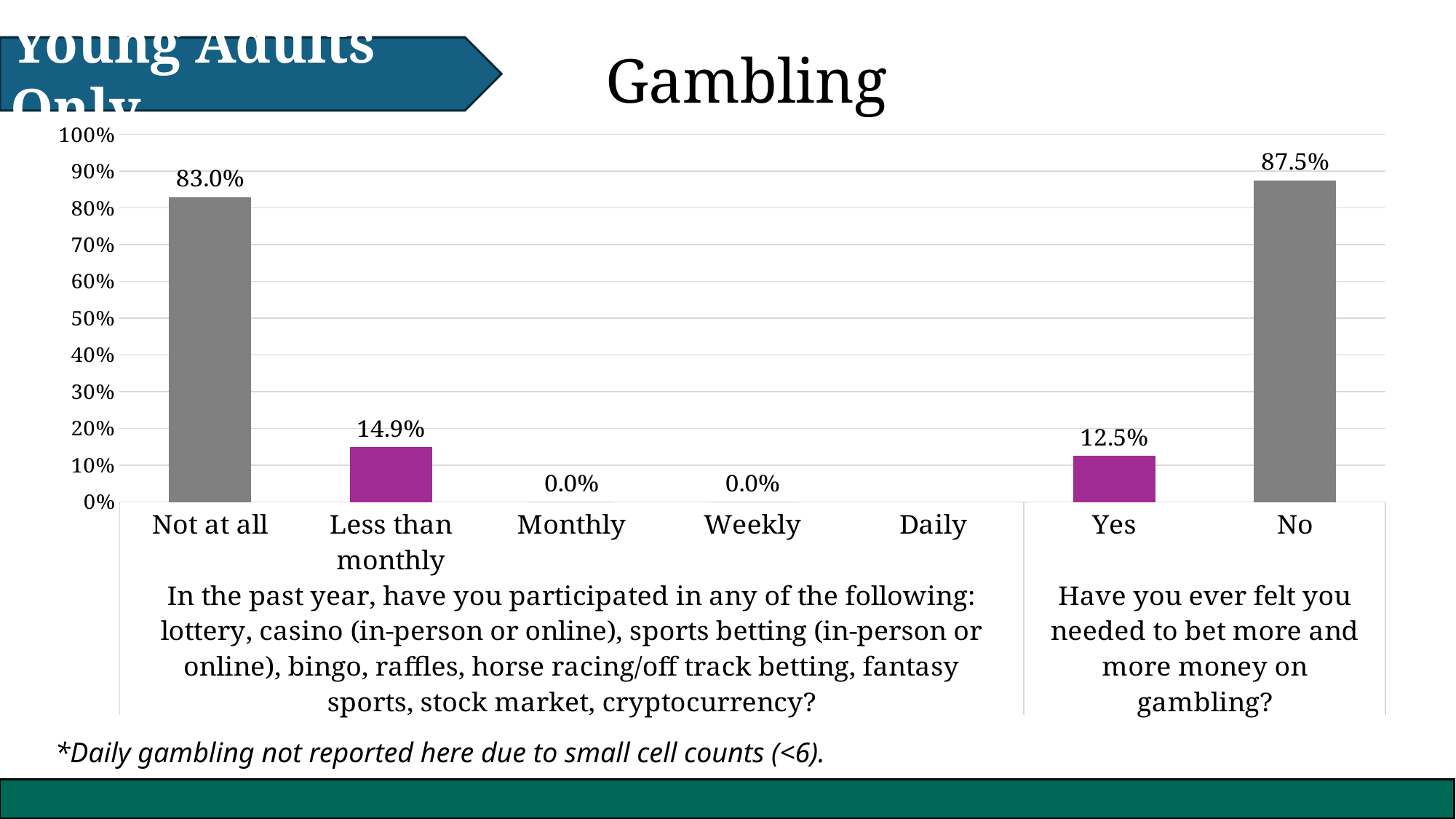
What is the value for "No" in response to whether respondents ever felt they needed to bet more and more money on gambling? 87.5% What is the difference between the values for "Not at all" and "Less than monthly"? 68.1% Which is larger, the value for "Less than monthly" or the value for "Yes"? Less than monthly Why is no value reported for "Daily" gambling? Small cell counts (<6) What is the value for "Yes" in response to whether respondents ever felt they needed to bet more and more money on gambling? 12.5% Which category has the highest value on the chart? No What is the value for "Monthly"? 0.0% What is the value for "Not at all"? 83.0% What is the value for "Less than monthly"? 14.9% Is the value for "Not at all" greater or less than 80%? greater What is the difference between the values for "No" and "Yes"? 75.0% What kind of chart is shown on the slide? Bar chart